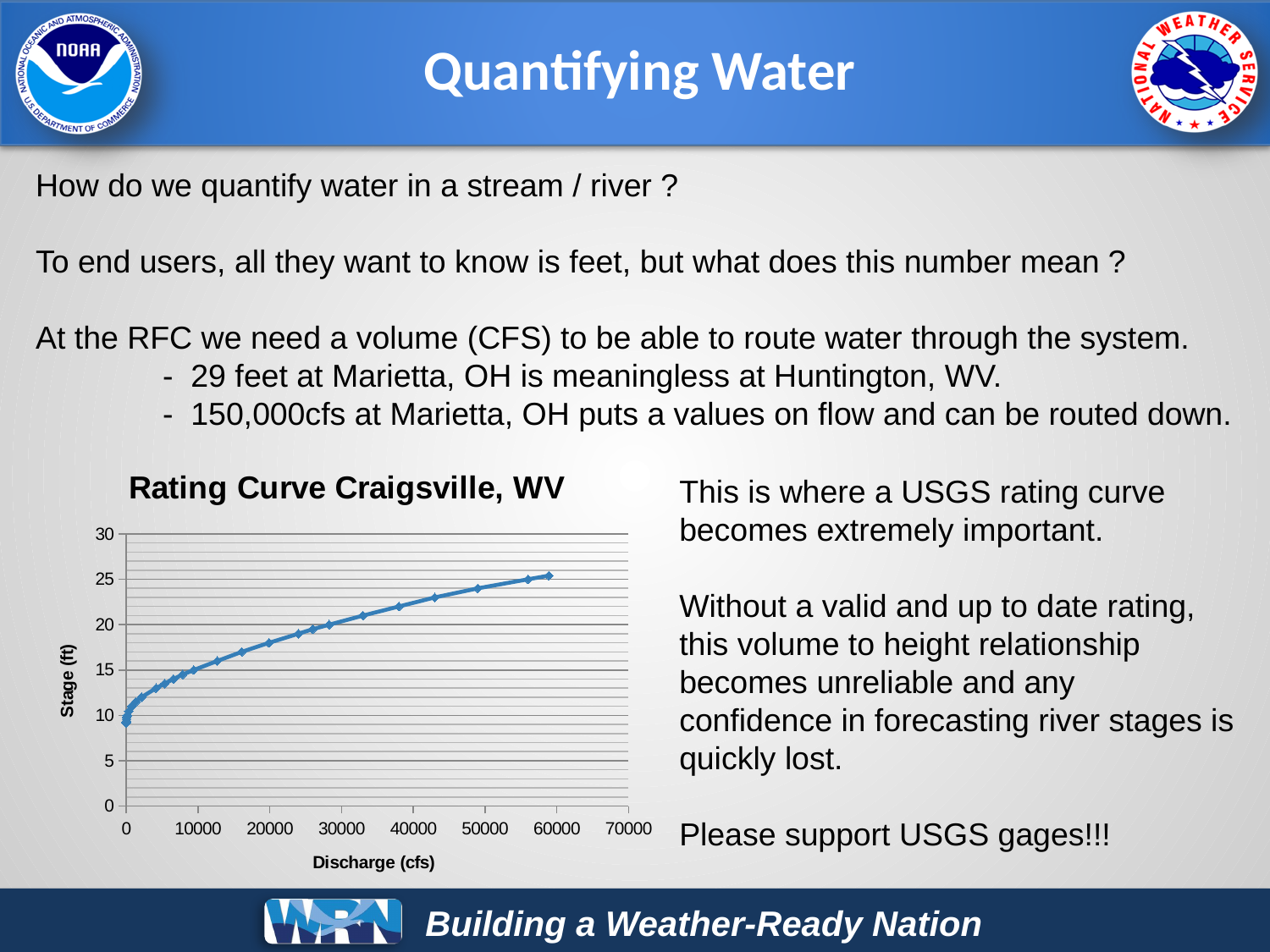
Which has the higher stage: the point at about 20000 cfs or the point at about 50000 cfs? the point at about 50000 cfs What is the maximum value shown on the y axis of the chart? 30 What kind of chart is shown on the slide? line chart Is the stage at a discharge of 10000 cfs greater or less than 20 ft? less Is the stage at the lowest plotted discharge greater or less than 15 ft? less Is the stage at a discharge of 30000 cfs greater or less than 15 ft? greater Does the stage rise or fall as discharge increases along the x axis? rise What is the label of the x axis of the chart? Discharge (cfs) What is the title of the chart on the slide? Rating Curve Craigsville, WV